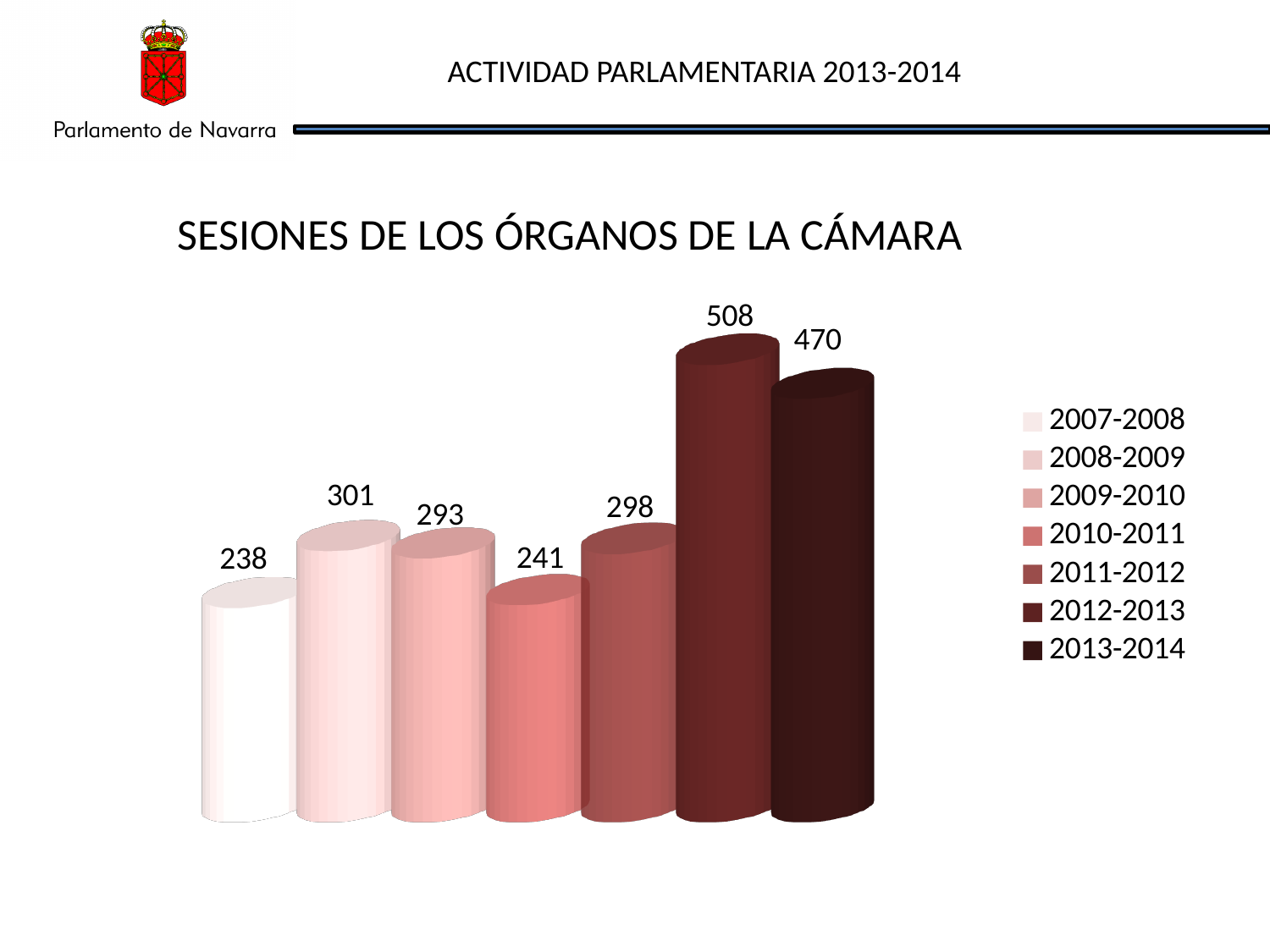
Which period has the lowest value? 2007-2008 What is the difference between the values for 2008-2009 and 2007-2008? 63 How many periods are plotted in the chart? 7 What is the difference between the values for 2012-2013 and 2013-2014? 38 What is the value for 2013-2014? 470 What is the title of the chart? SESIONES DE LOS ÓRGANOS DE LA CÁMARA What is the value for 2007-2008? 238 What kind of chart is shown on the slide? bar chart Which is larger, the value for 2009-2010 or the value for 2011-2012? 2011-2012 What is the value for 2010-2011? 241 Which period has the highest value? 2012-2013 What is the value for 2012-2013? 508